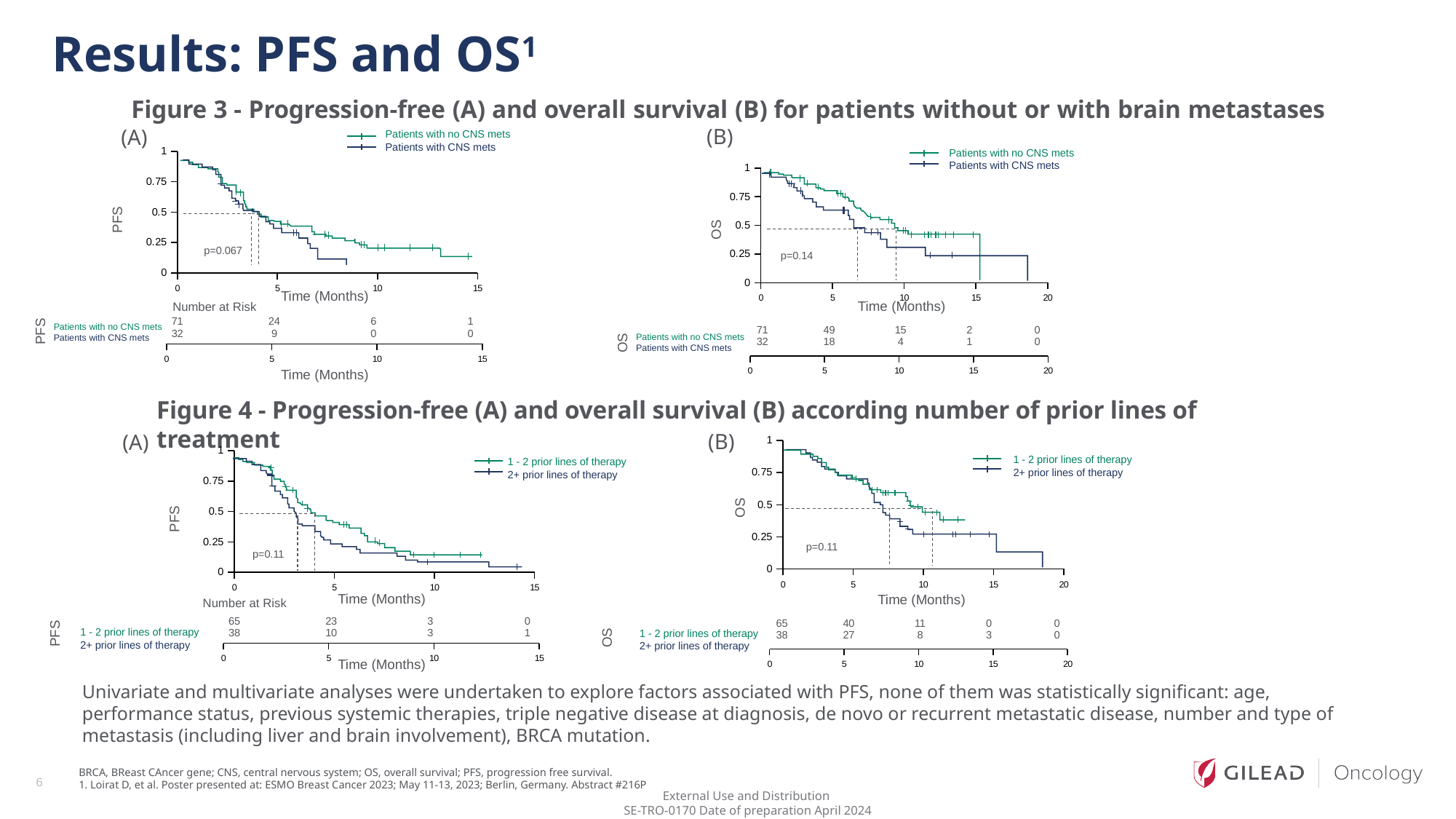
In Figure 4 panel (B), at 5 months, which group has more patients at risk: 1 - 2 prior lines of therapy or 2+ prior lines of therapy? 1 - 2 prior lines of therapy In Figure 4 panel (A), what is the number at risk at 5 months for patients with 1 - 2 prior lines of therapy? 23 In Figure 3 panel (A), is the PFS value for patients with no CNS mets at 10 months greater or less than 0.5? less In Figure 4 panel (B), what is the number at risk at 10 months for patients with 2+ prior lines of therapy? 8 In Figure 3 panel (B), do the OS curves rise or fall as time increases? fall In Figure 3 panel (A), what is the number at risk at 0 months for patients with no CNS mets? 71 In Figure 3 panel (B), what is the difference between the number at risk at 0 months for patients with no CNS mets and for patients with CNS mets? 39 In Figure 3 panel (B), what is the number at risk at 5 months for patients with CNS mets? 18 In Figure 3 panel (B), what is the number at risk at 15 months for patients with no CNS mets? 2 How many series does the legend of Figure 3 panel (A) list? 2 In Figure 4 panel (B), what p-value is printed on the OS chart? p=0.11 In Figure 3 panel (A), what p-value is printed on the PFS chart? p=0.067